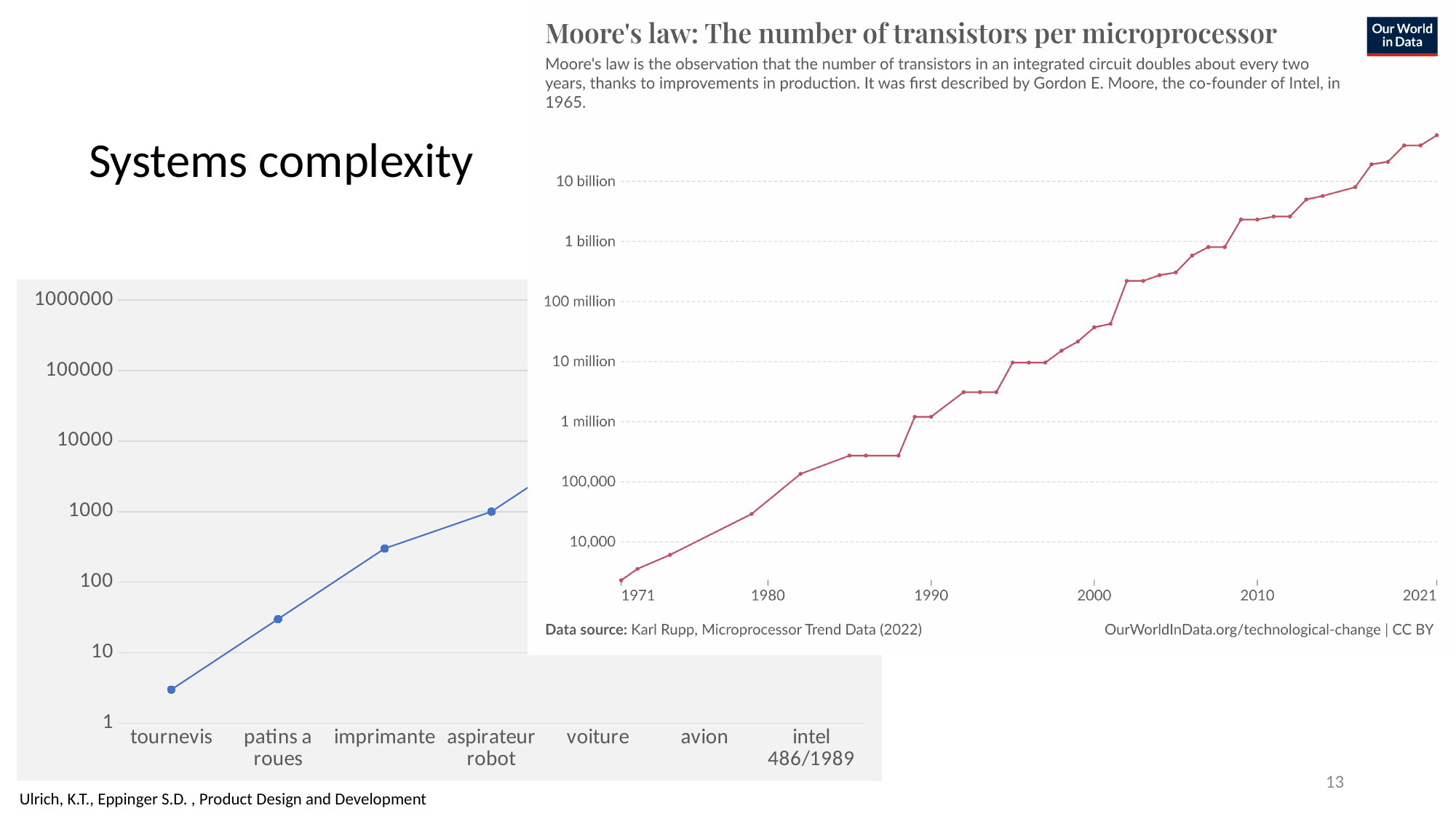
In the left chart, which is larger, the value for imprimante or the value for patins a roues? imprimante In the left chart, is the value for imprimante greater or less than 100? greater In the left chart, what value does the point for aspirateur robot land on? 1000 In the left chart, is the value for patins a roues greater or less than 10? greater In the left chart, is the value for tournevis greater or less than 10? less In the Moore's law chart, do the number of transistors per microprocessor rise or fall from 1971 to 2021? rise What kind of chart is the Moore's law chart on the right? line chart How many categories are listed on the x axis of the left chart? 7 What is the title of the chart on the right of the slide? Moore's law: The number of transistors per microprocessor In the left chart, do the values rise or fall from tournevis to aspirateur robot? rise What kind of chart is the left chart on the slide (the one with categories such as tournevis and imprimante)? line chart